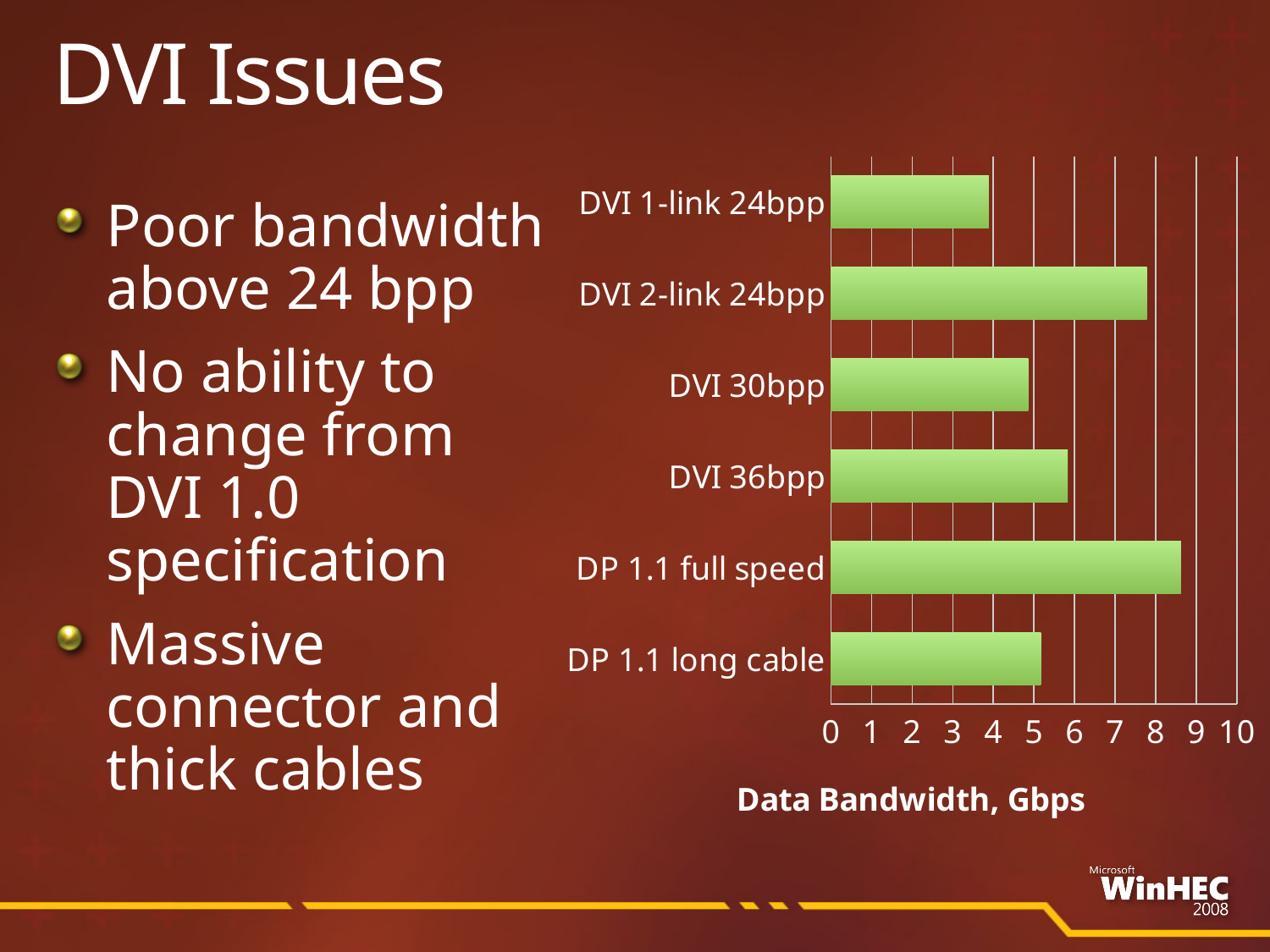
What is the axis label shown below the chart? Data Bandwidth, Gbps Is the value for DVI 36bpp greater or less than 5? greater Is the value for DVI 2-link 24bpp greater or less than 7? greater How many categories are plotted in the chart? 6 Is the value for DVI 1-link 24bpp greater or less than 5? less What kind of chart is shown on the slide? bar chart Which category has the highest data bandwidth in the chart? DP 1.1 full speed Which category has the lowest data bandwidth in the chart? DVI 1-link 24bpp Which has the larger data bandwidth, DVI 2-link 24bpp or DVI 36bpp? DVI 2-link 24bpp